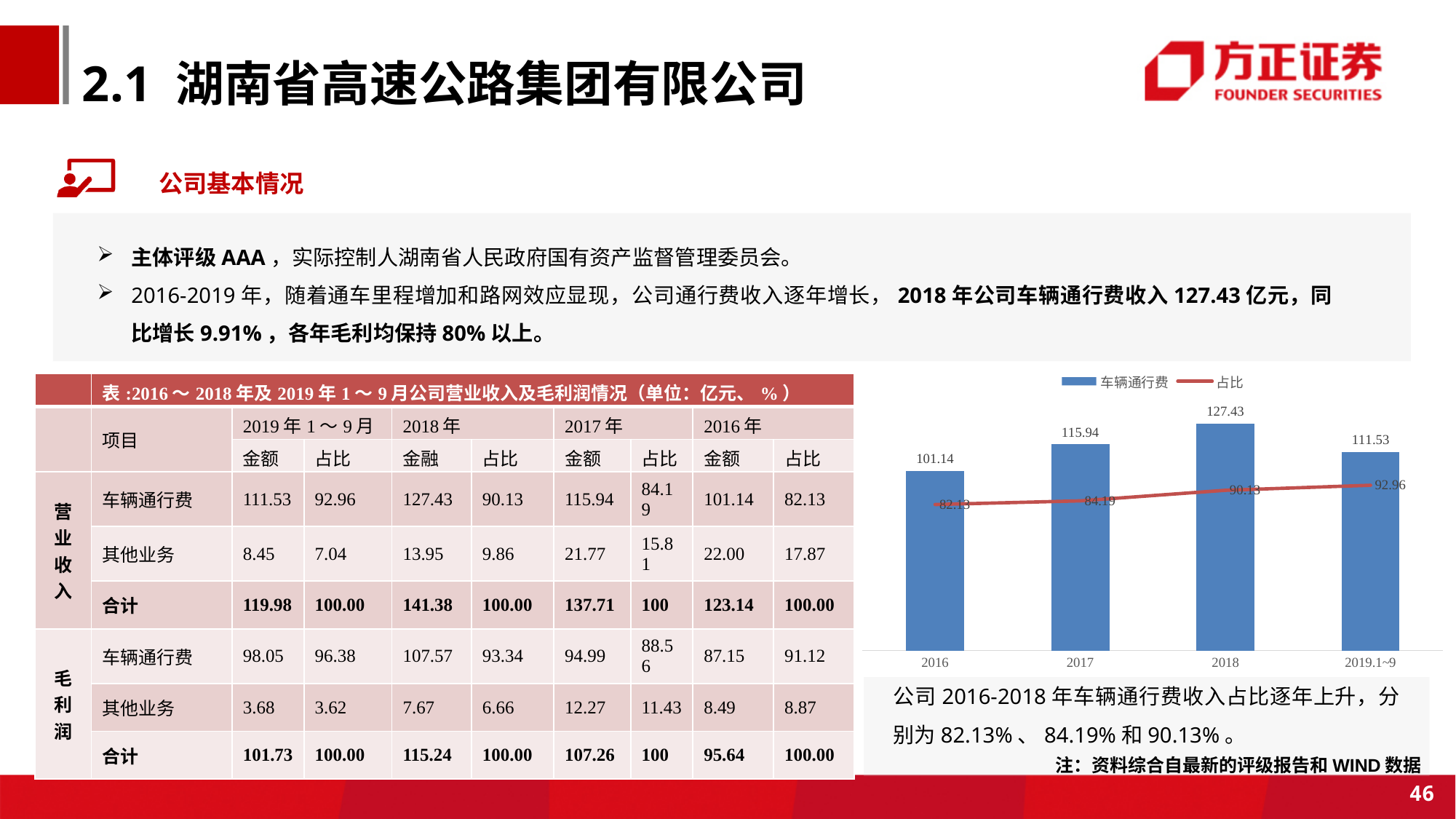
Which year has the highest 车辆通行费 bar in the chart? 2018 What is the difference between the 车辆通行费 values for 2018 and 2017 in the chart? 11.49 What is the value of 车辆通行费 for 2016 in the chart? 101.14 What is the value of 车辆通行费 for 2018 in the chart? 127.43 Is the 车辆通行费 bar for 2017 larger or smaller than the bar for 2019.1~9? larger What is the 占比 value for 2017 in the chart? 84.19 Which category has the lowest 车辆通行费 bar in the chart? 2016 What kind of chart is shown on the slide? Combined bar and line chart How many series does the chart legend list? 2 Does the 占比 line rise or fall from 2016 to 2019.1~9? rise What is the 占比 value for 2019.1~9 in the chart? 92.96 How many categories are shown on the x axis of the chart? 4